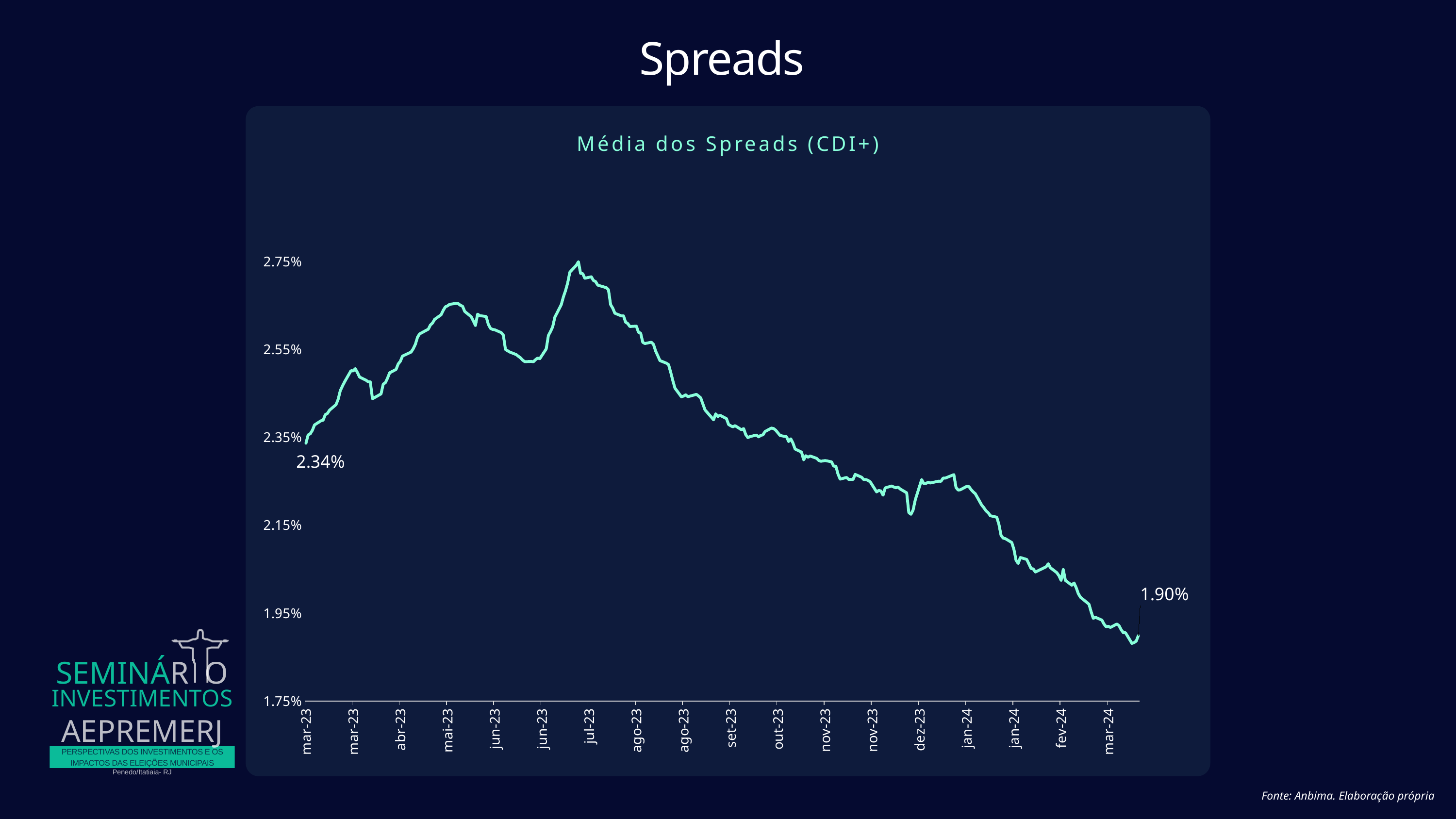
What is the value labelled at the start of the line (mar-23)? 2.34% Is the value of the line at dez-23 greater or less than 2.35%? less Around which month does the line reach its highest point? jul-23 How many date labels are shown along the x axis? 18 Around which month does the line reach its lowest point? mar-24 What is the difference between the starting value (2.34%) and the ending value (1.90%) of the line? 0.44 percentage points What kind of chart is shown on the slide? line chart Overall, does the line rise or fall from mar-23 to mar-24? fall Which is larger, the value at the start of the line or the value at the end? the start (2.34%) What is the value labelled at the end of the line (mar-24)? 1.90% Is the peak value of the line around jul-23 greater or less than 2.55%? greater What is the title of the chart? Média dos Spreads (CDI+)